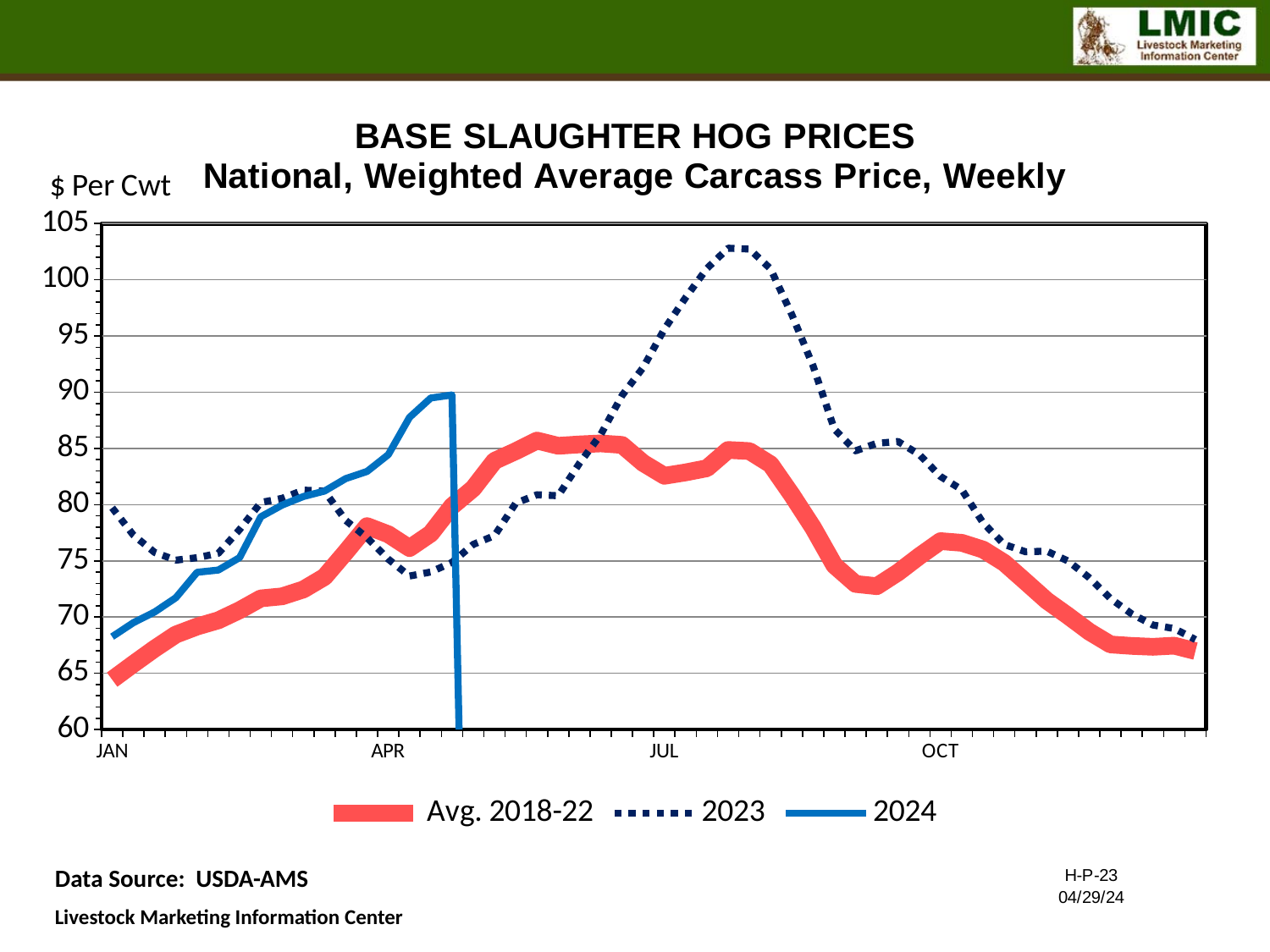
How many month labels are shown on the x axis? 4 Which series is drawn as a dotted line in the chart? 2023 Which series reaches the highest value anywhere on the chart? 2023 Does the Avg. 2018-22 series rise or fall between JAN and APR? rise Is the value of the 2023 series at JAN greater or less than 75? greater Is the peak value of the 2023 series greater or less than 100? greater Is the value of the Avg. 2018-22 series at JAN greater or less than 70? less What is the unit label shown on the y axis of the chart? $ Per Cwt How many series does the legend list? 3 What kind of chart is shown on the slide? line chart At JAN, which series has the higher value: 2024 or Avg. 2018-22? 2024